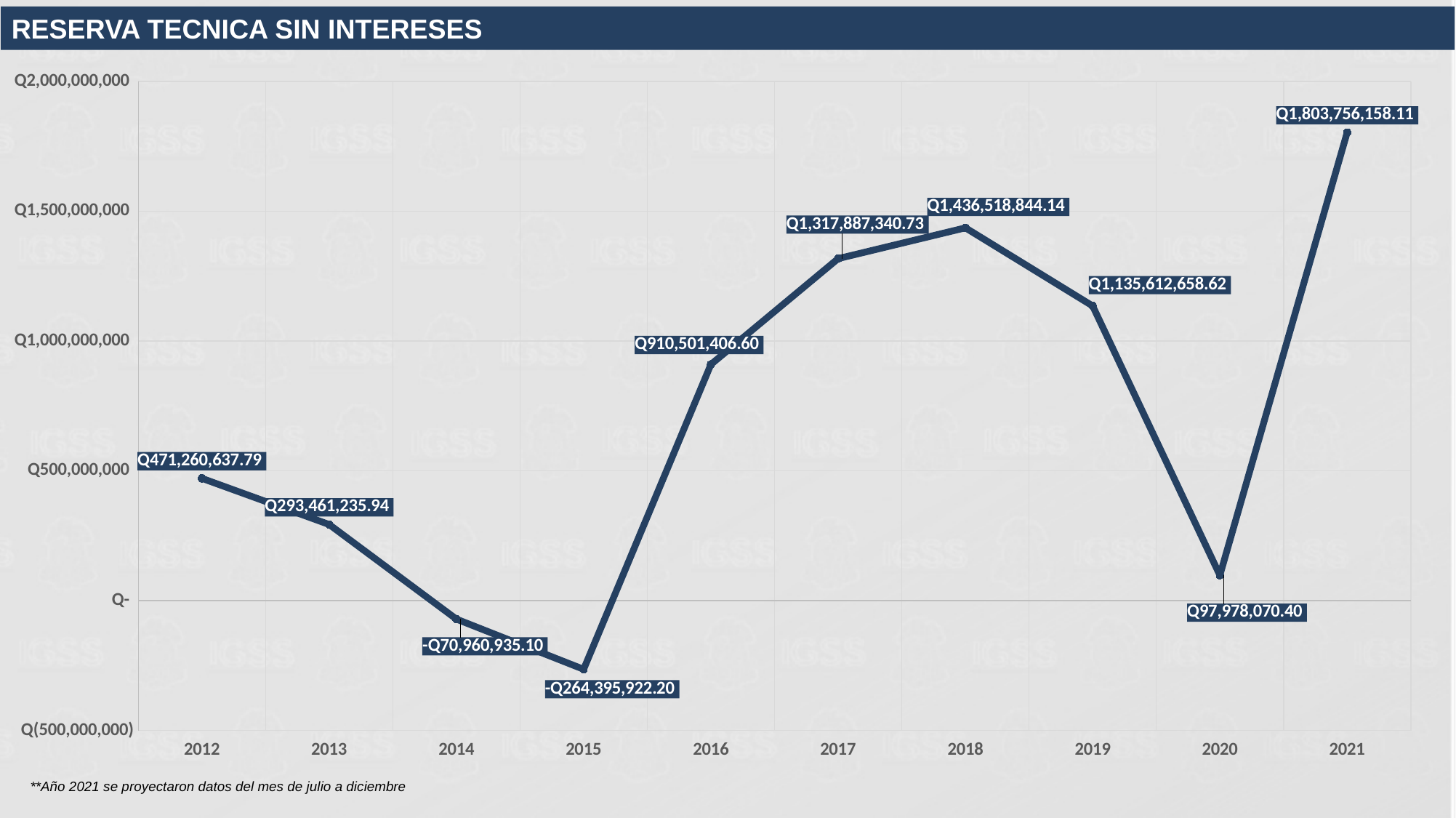
What is the difference between the values for 2018 and 2017? Q118,631,503.41 Which year has the lowest value? 2015 Which year has the highest value? 2021 What is the value for 2015? -Q264,395,922.20 What is the value for 2017? Q1,317,887,340.73 How many years are plotted on the chart? 10 What is the difference between the values for 2012 and 2013? Q177,799,401.85 What is the value for 2020? Q97,978,070.40 Do the values rise or fall from 2012 to 2015? Fall What is the value for 2021? Q1,803,756,158.11 What kind of chart is shown? Line chart Which is larger, the value for 2016 or the value for 2019? 2019